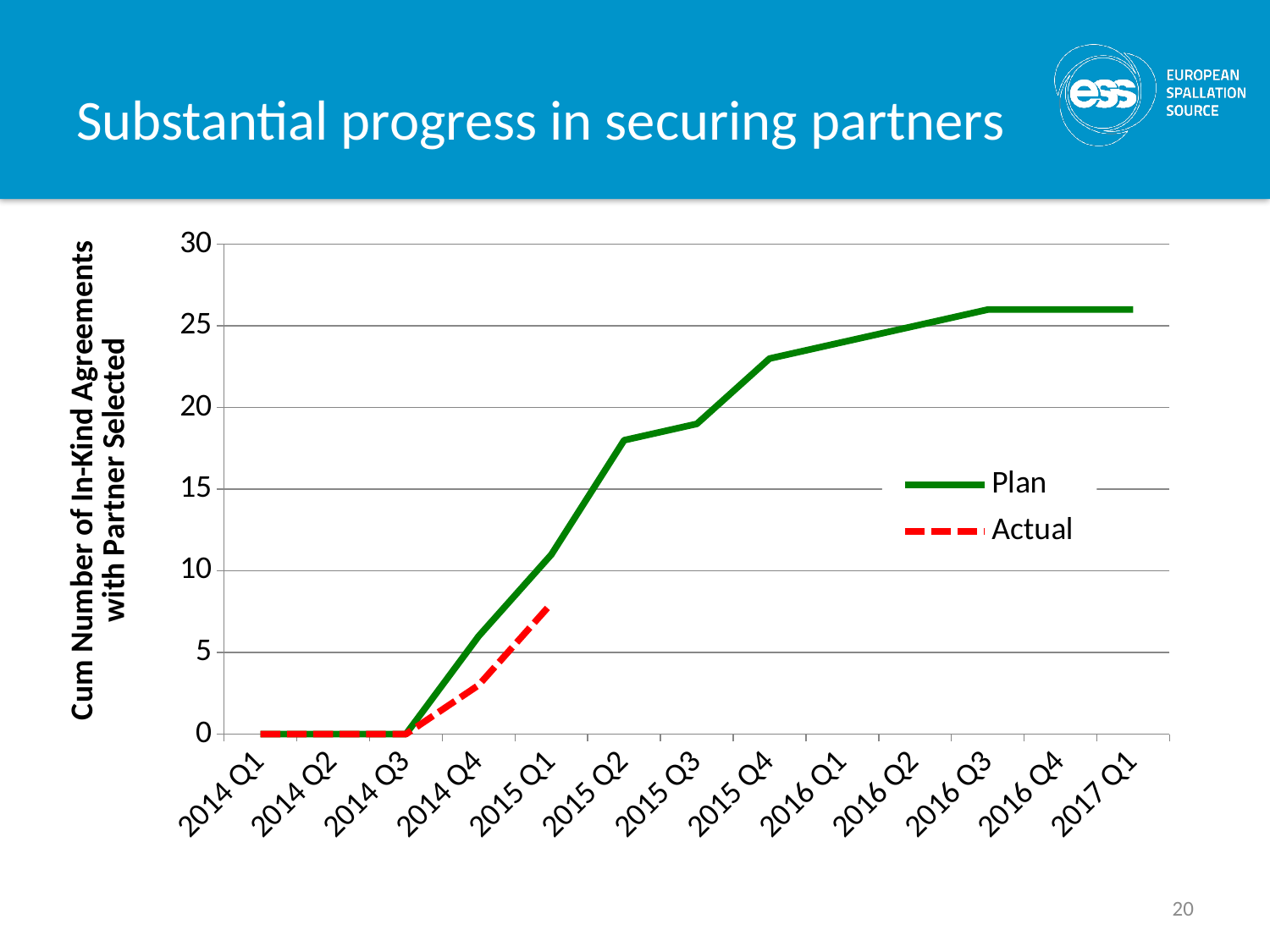
Does the Plan series rise or fall from 2014 Q3 to 2016 Q3? rise What is the Actual value for 2014 Q3? 0 At 2015 Q1, which series has the larger value, Plan or Actual? Plan What kind of chart is shown on the slide? line chart Is the Plan value for 2017 Q1 greater or less than 25? greater Is the Plan value for 2015 Q2 greater or less than 15? greater How many series does the legend list? 2 Is the Actual value for 2015 Q1 greater or less than 10? less What is the y-axis title of the chart? Cum Number of In-Kind Agreements with Partner Selected How many quarters are shown on the x axis? 13 What is the Plan value for 2014 Q1? 0